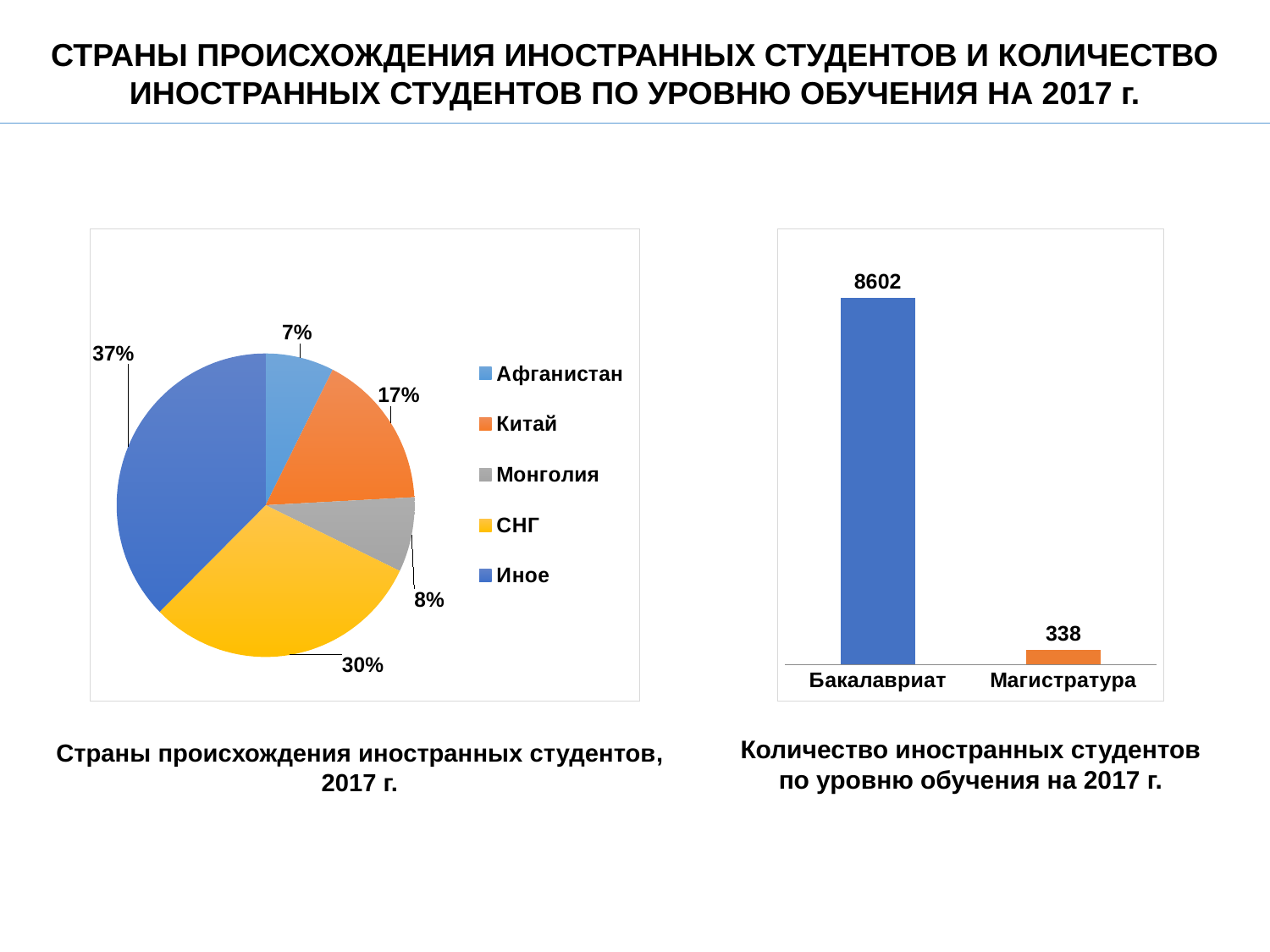
What type of chart is shown on the right side of the slide? Bar chart In the pie chart on the left, which category has the largest share? Иное In the chart on the right, what is the difference between the number of students in Бакалавриат and Магистратура? 8264 In the pie chart on the left, how many categories does the legend list? 5 In the chart on the right, how many foreign students are in Магистратура? 338 In the pie chart on the left, what is the difference in percentage points between Иное and СНГ? 7 In the pie chart on the left, which category has the smallest share? Афганистан In the chart on the right, how many foreign students are in Бакалавриат? 8602 In the pie chart on the left, what share of foreign students comes from Афганистан? 7% In the pie chart on the left, what share is labelled for СНГ? 30% In the pie chart on the left, which has a larger share, Монголия or Китай? Китай In the pie chart on the left, what share of foreign students comes from Китай? 17%